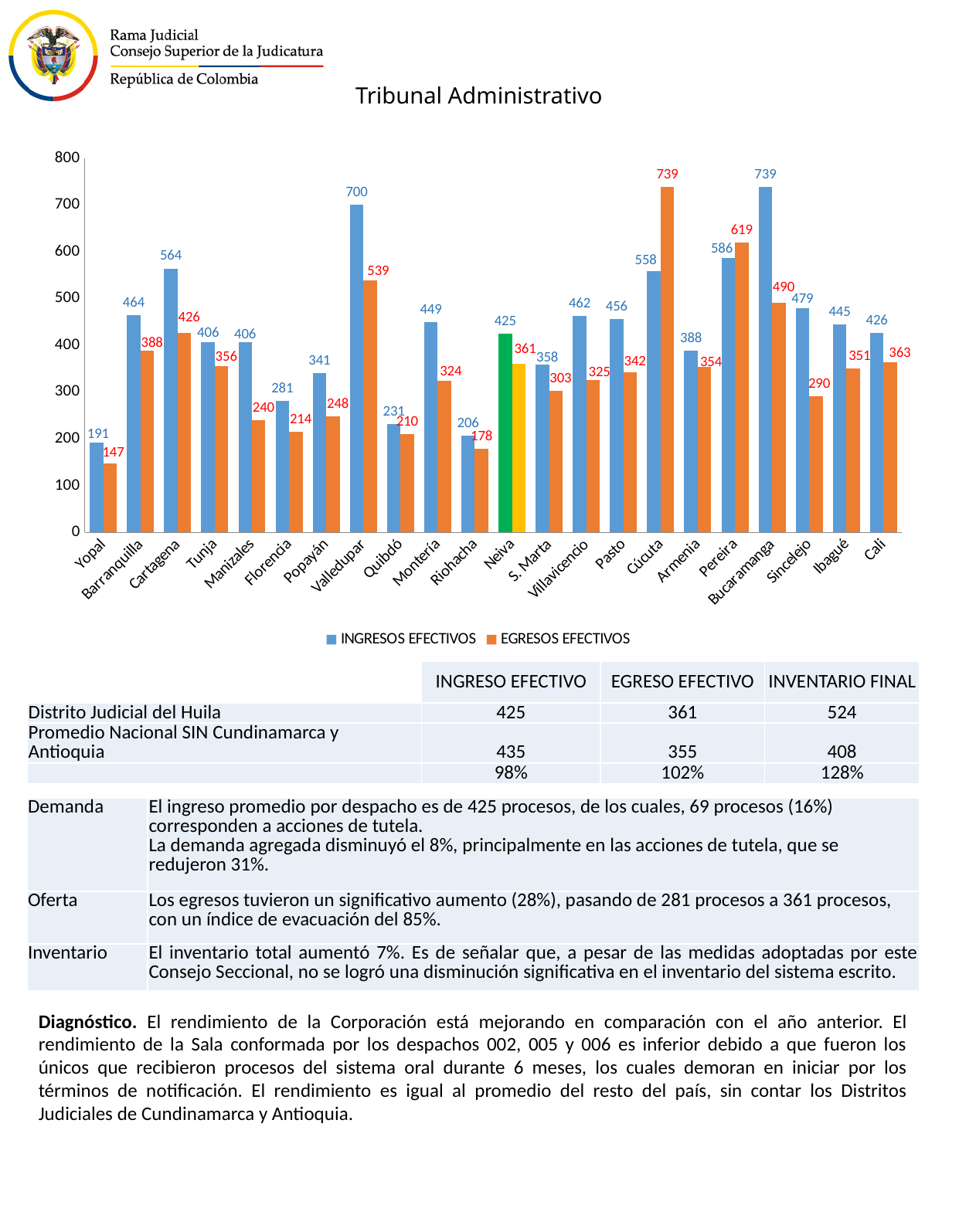
What is the EGRESOS EFECTIVOS value for Cúcuta? 739 What kind of chart is shown on the slide? bar chart Which city has the highest INGRESOS EFECTIVOS value? Bucaramanga How many series does the chart legend list? 2 What is the difference between INGRESOS EFECTIVOS and EGRESOS EFECTIVOS for Pereira? 33 What is the title of the chart? Tribunal Administrativo Which is larger for Cúcuta, INGRESOS EFECTIVOS or EGRESOS EFECTIVOS? EGRESOS EFECTIVOS How many cities are shown on the x axis of the chart? 22 What is the INGRESOS EFECTIVOS value for Valledupar? 700 Which city has the lowest EGRESOS EFECTIVOS value? Yopal What is the INGRESOS EFECTIVOS value for Neiva? 425 Is the EGRESOS EFECTIVOS value for Sincelejo greater or less than 300? less